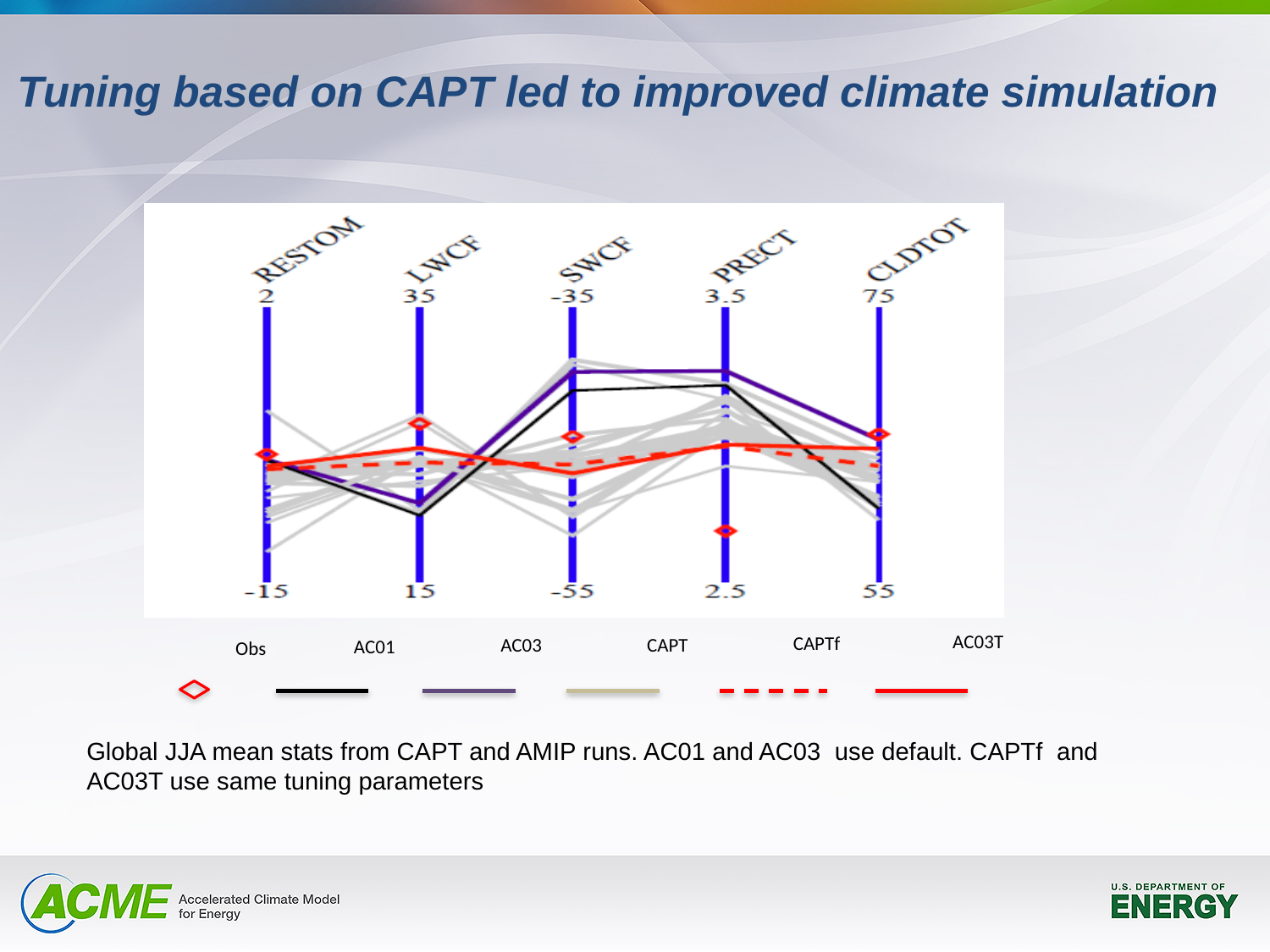
What range does the PRECT axis span, from bottom to top? 2.5 to 3.5 What is the value at the top of the LWCF axis? 35 What kind of chart is shown on the slide? Parallel coordinates line chart What is the value at the top of the RESTOM axis? 2 What is the value at the bottom of the SWCF axis? -55 What is the value at the top of the CLDTOT axis? 75 How many series does the legend list? 6 On the PRECT axis, which is higher: Obs or AC03? AC03 On the LWCF axis, which is higher: Obs or AC01? Obs Which series is shown with a red diamond marker in the legend? Obs What is the value at the bottom of the RESTOM axis? -15 How many vertical axes (variables) does the chart have? 5